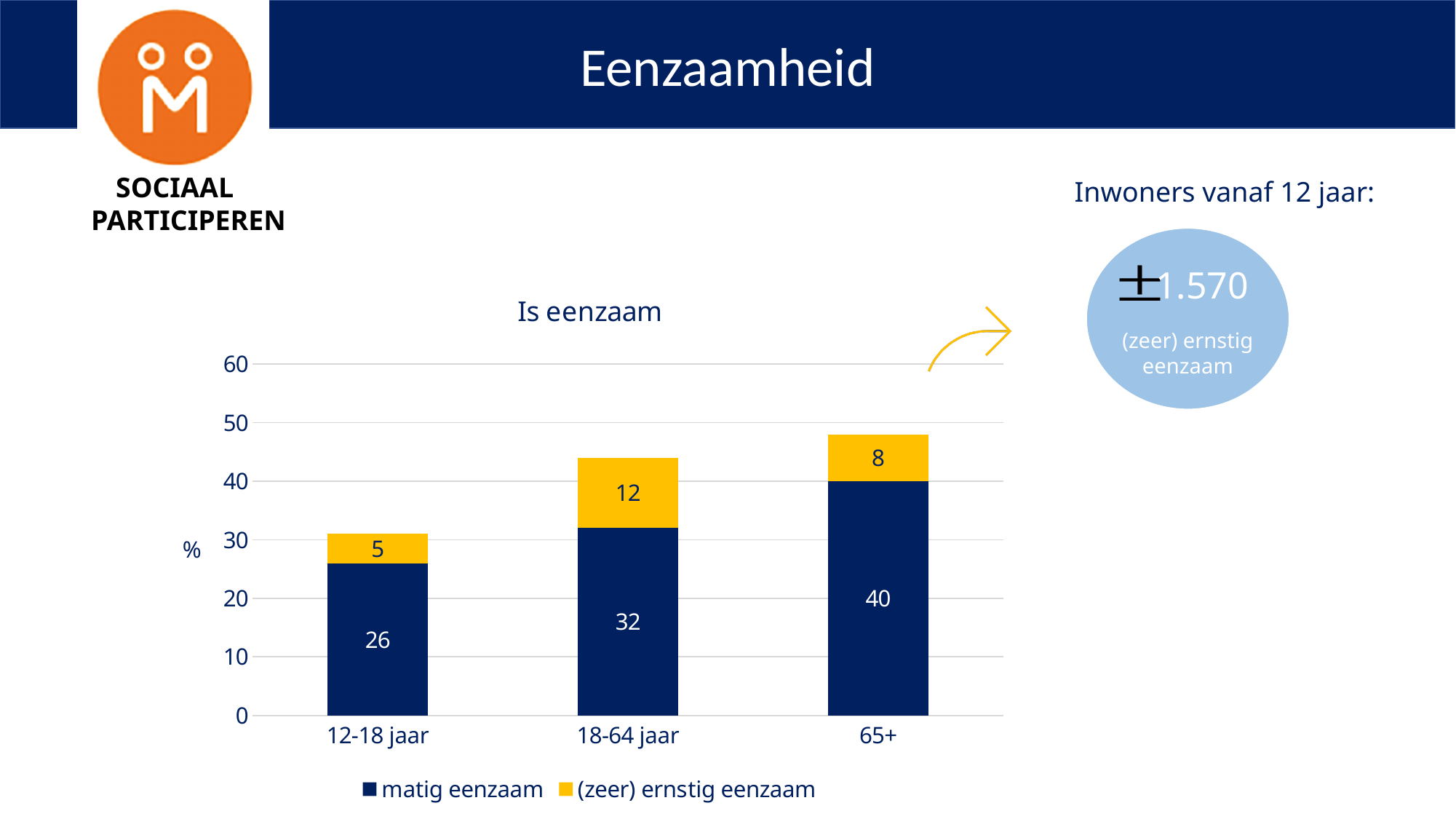
What is the total of the stacked bar for 18-64 jaar? 44 Which is larger: '(zeer) ernstig eenzaam' for 18-64 jaar or for 65+? 18-64 jaar Which age category has the lowest value for '(zeer) ernstig eenzaam'? 12-18 jaar What kind of chart is shown? Stacked bar chart What is the title of the chart? Is eenzaam What is the value for '(zeer) ernstig eenzaam' in the 18-64 jaar category? 12 What is the difference between the 'matig eenzaam' values for 65+ and 12-18 jaar? 14 What is the value for 'matig eenzaam' in the 12-18 jaar category? 26 How many age categories are shown on the x axis? 3 Which age category has the highest value for 'matig eenzaam'? 65+ What is the value for 'matig eenzaam' in the 65+ category? 40 How many series does the legend list? 2